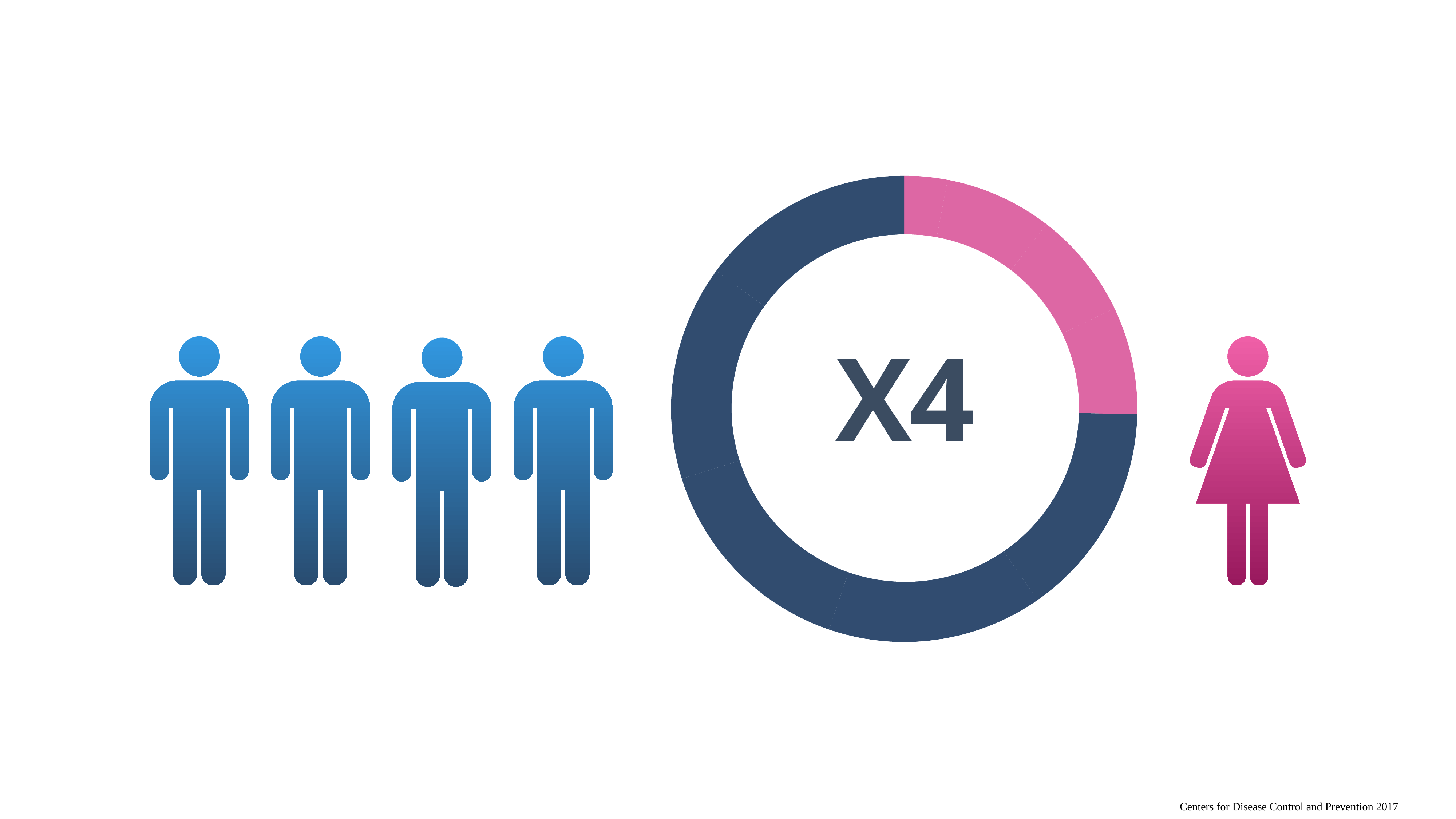
What source is cited at the bottom right of the slide? Centers for Disease Control and Prevention 2017 What text is printed in the centre of the donut chart? X4 How many segments does the donut chart have? 2 Which segment of the donut chart is larger, the dark blue one or the pink one? Dark blue Which segment of the donut chart is the smallest? Pink What kind of chart is shown in the centre of the slide? Donut chart